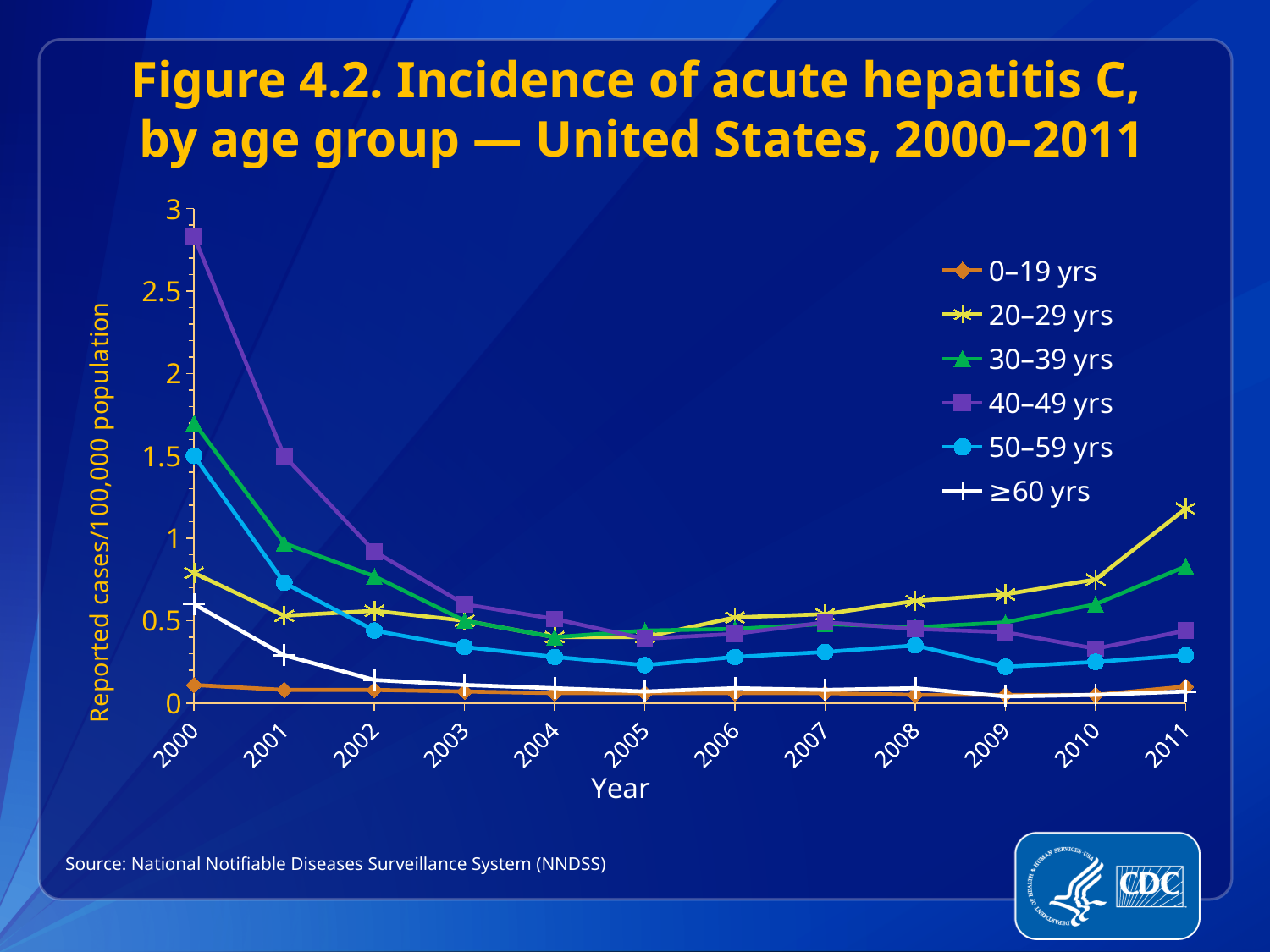
Is the value for the 20–29 yrs group in 2011 greater or less than 1? greater In 2011, which is larger: the value for 20–29 yrs or for 30–39 yrs? 20–29 yrs Which age group had the highest incidence in 2011? 20–29 yrs Which age group had the lowest incidence in 2000? 0–19 yrs Is the value for the 40–49 yrs group in 2000 greater or less than 2.5? greater Which age group had the highest incidence in 2000? 40–49 yrs What is the label of the y axis? Reported cases/100,000 population Does the incidence for the 40–49 yrs group rise or fall from 2000 to 2005? fall How many years are plotted along the x axis? 12 What kind of chart is shown on the slide? line chart How many age groups does the legend list? 6 Is the value for the 0–19 yrs group in 2000 greater or less than 0.5? less